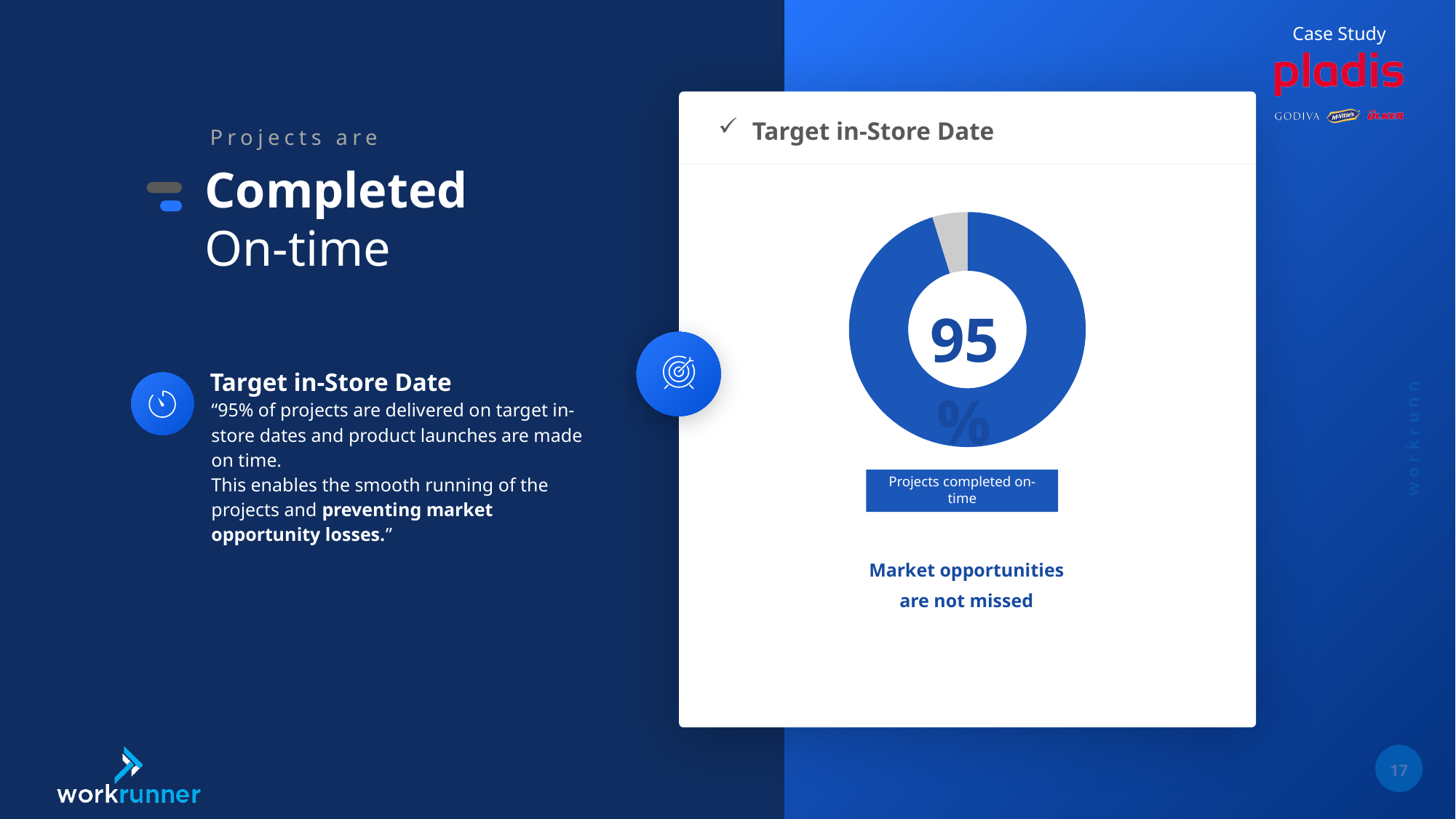
What percentage of projects are completed on-time according to the donut chart? 95% How many slices does the donut chart have? 2 What kind of chart is shown on the slide? Donut (pie) chart Which slice of the donut chart is larger, the blue one or the grey one? The blue one What share of the donut chart does the blue slice (projects completed on-time) represent? 95% What label is shown in the blue box below the donut chart? Projects completed on-time What is the difference between the blue slice and the grey slice of the donut chart, in percentage points? 90 What share of the donut chart does the grey slice represent? 5% What is the title of the card containing the donut chart? Target in-Store Date Is the value shown in the centre of the donut chart greater or less than 90? greater